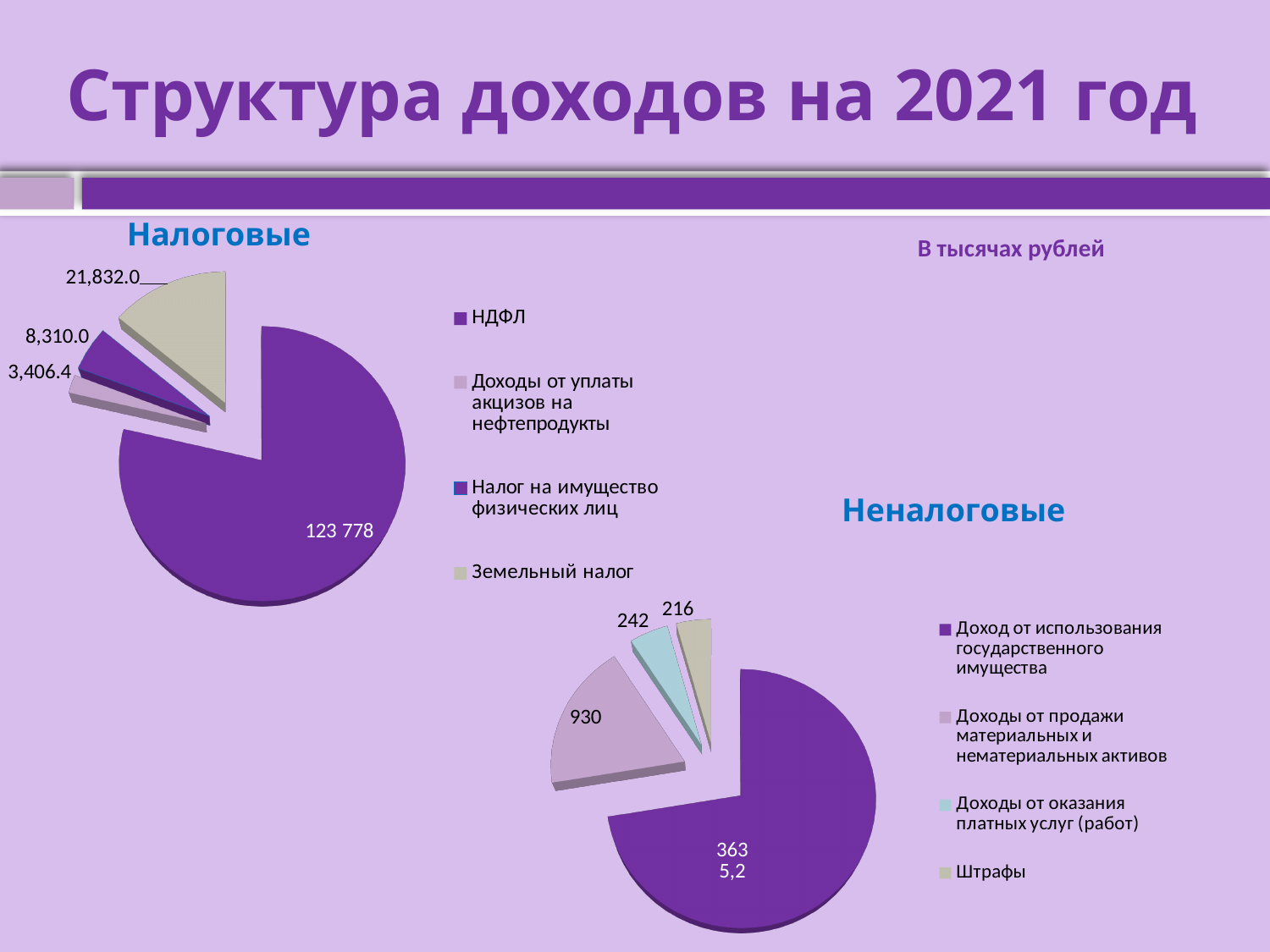
What kind of chart is the "Налоговые" chart? pie chart In the "Налоговые" chart, what is the value for НДФЛ? 123 778 In the "Неналоговые" chart, what is the value for Штрафы? 216 In the "Налоговые" chart, what is the difference between Земельный налог and Налог на имущество физических лиц? 13,522.0 In the "Неналоговые" chart, which is larger: Доходы от оказания платных услуг (работ) or Штрафы? Доходы от оказания платных услуг (работ) In the "Неналоговые" chart, which category has the largest value? Доход от использования государственного имущества In the "Налоговые" chart, what is the value for Налог на имущество физических лиц? 8,310.0 In what units are the values on the slide given? В тысячах рублей In the "Налоговые" chart, which category has the smallest value? Доходы от уплаты акцизов на нефтепродукты In the "Налоговые" chart, what is the value for Земельный налог? 21,832.0 In the "Неналоговые" chart, what is the value for Доходы от продажи материальных и нематериальных активов? 930 How many categories does the "Налоговые" pie chart show? 4